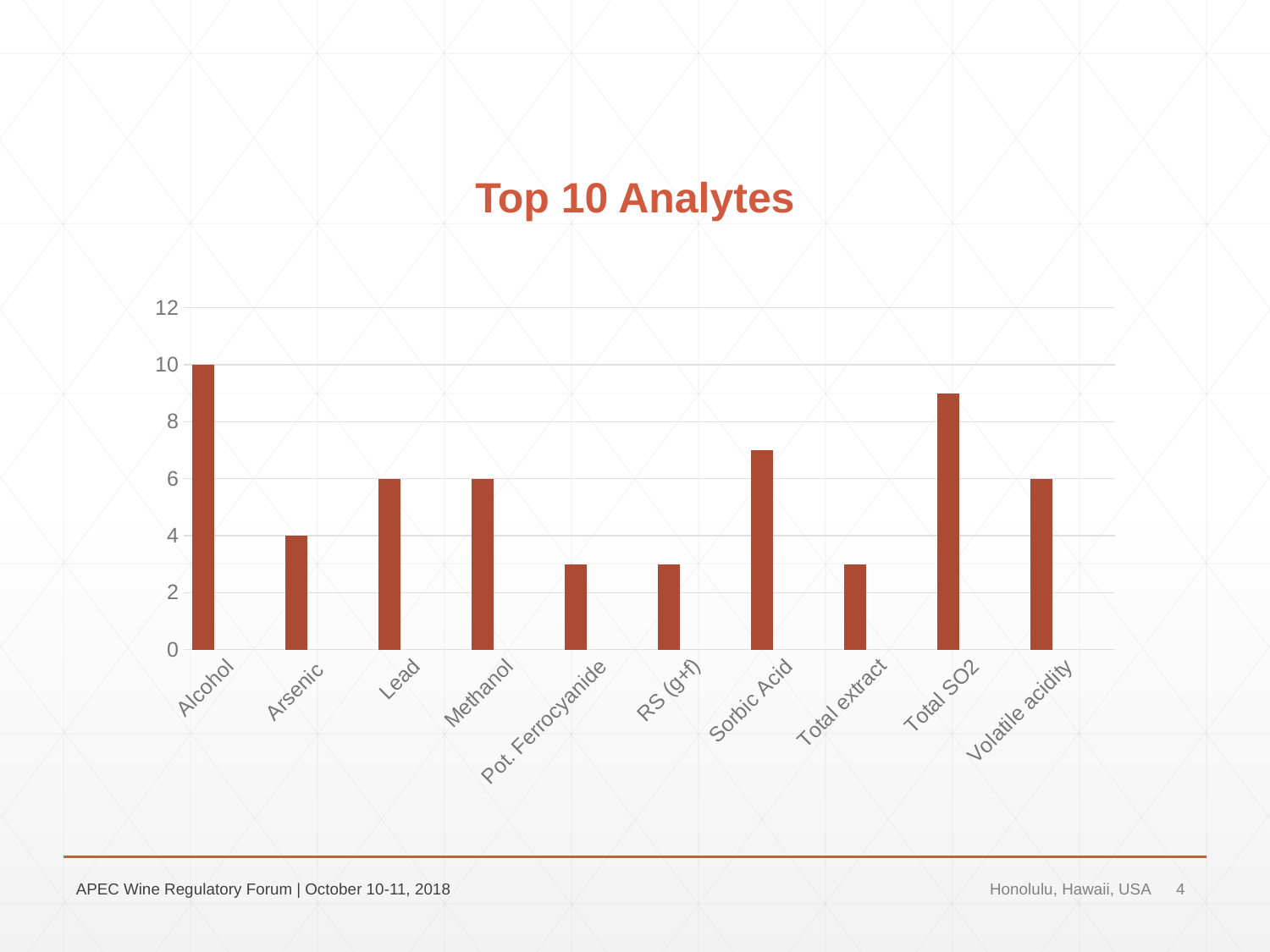
What is the value for Volatile acidity? 6 What is the value for Alcohol? 10 Is the value for Pot. Ferrocyanide greater or less than 4? less Which has a larger value, Total SO2 or Sorbic Acid? Total SO2 Is the value for Sorbic Acid greater or less than 6? greater What is the title of the chart? Top 10 Analytes What is the difference between the values for Alcohol and Arsenic? 6 Which analyte has the highest value? Alcohol What is the value for Arsenic? 4 What is the value for Lead? 6 What kind of chart is shown on the slide? bar chart How many analytes (categories) are plotted in the chart? 10